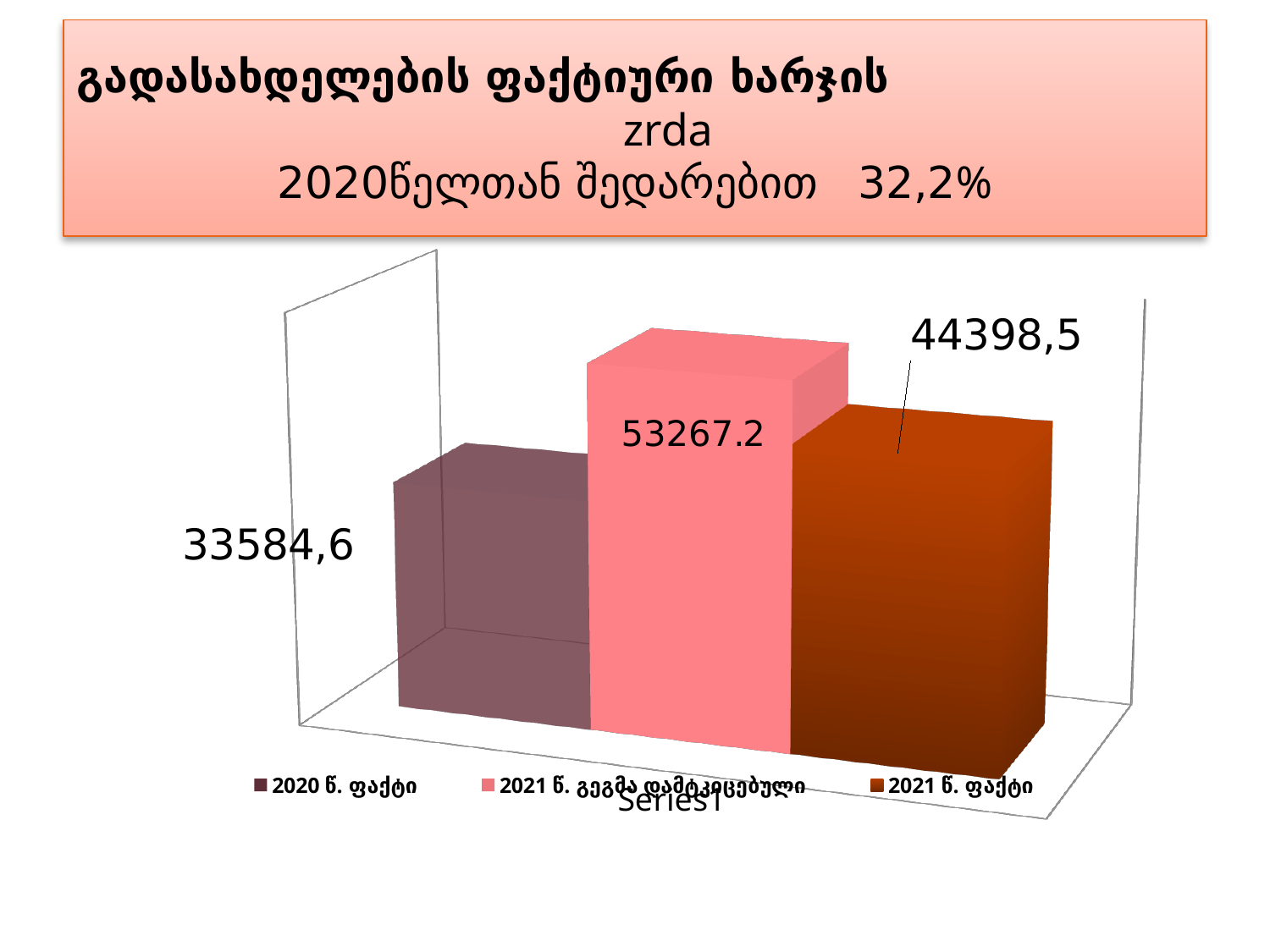
What is the difference between the values for "2021 წ. ფაქტი" and "2020 წ. ფაქტი"? 10813,9 Which series has the highest value? 2021 წ. გეგმა დამტკიცებული How many bars are plotted in the chart? 3 Which series has the lowest value? 2020 წ. ფაქტი Which is larger, the value for "2021 წ. ფაქტი" or the value for "2021 წ. გეგმა დამტკიცებული"? 2021 წ. გეგმა დამტკიცებული What is the value for the series "2021 წ. ფაქტი"? 44398,5 What is the value for the series "2020 წ. ფაქტი"? 33584,6 What is the value for the series "2021 წ. გეგმა დამტკიცებული"? 53267.2 How many series does the legend list? 3 Which is larger, the value for "2020 წ. ფაქტი" or the value for "2021 წ. ფაქტი"? 2021 წ. ფაქტი What kind of chart is shown on the slide? Bar chart What is the label on the category axis of the chart? Series1